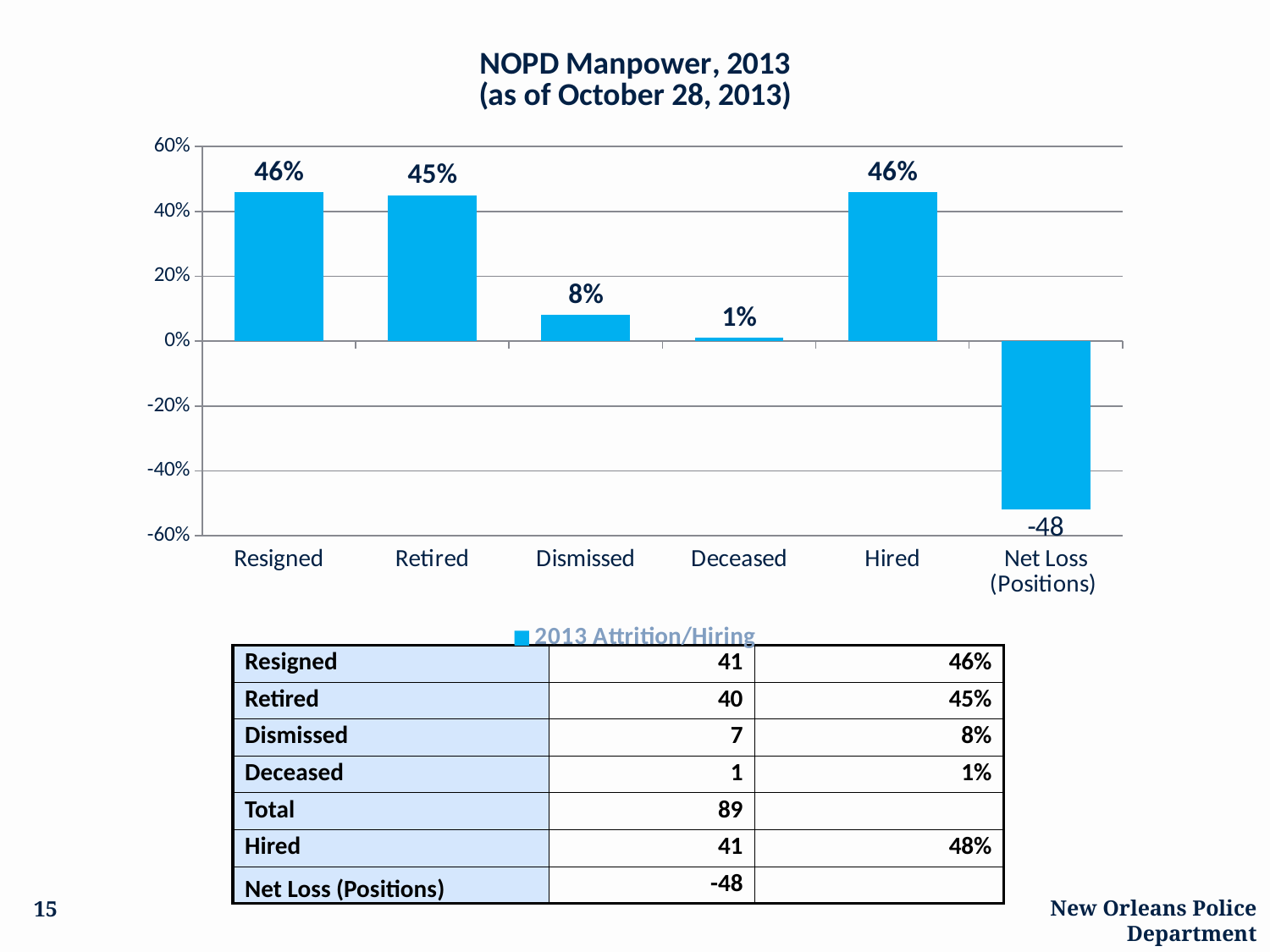
What is the difference between the values for Resigned and Dismissed? 38 percentage points Which category has the lowest positive value among the attrition categories (Resigned, Retired, Dismissed, Deceased)? Deceased What is the value for Resigned? 46% Is the value for Net Loss (Positions) greater or less than -40%? less How many categories are shown on the x axis? 6 How many series does the legend list? 1 What is the value for Dismissed? 8% What is the value for Deceased? 1% What is the value labelled on the Net Loss (Positions) bar? -48 What is the value for Retired? 45% Which is larger, the value for Retired or the value for Dismissed? Retired What kind of chart is shown on the slide? Bar chart